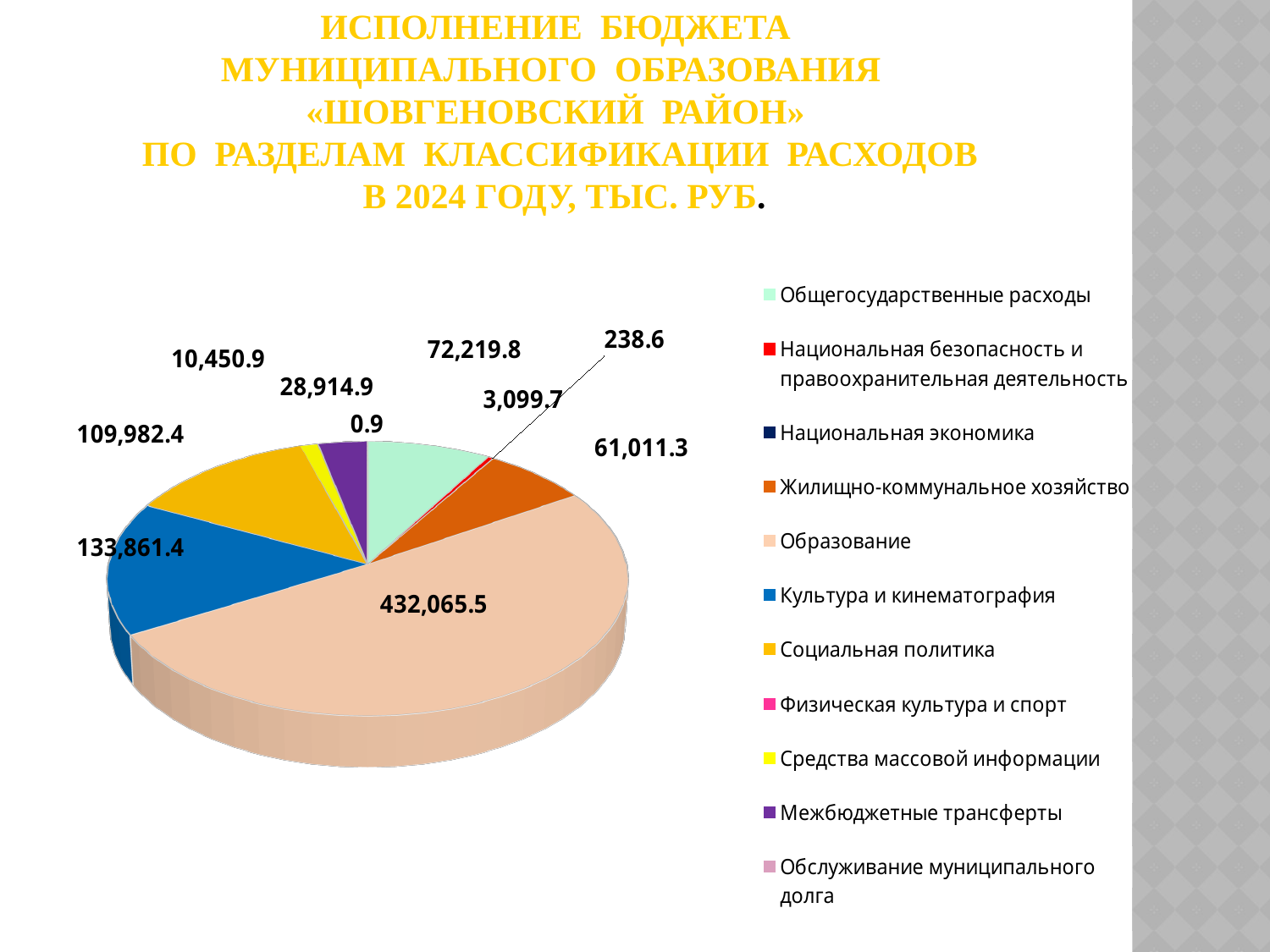
What is the difference between the values for Культура и кинематография and Социальная политика? 23,879.0 What is the value for Общегосударственные расходы? 72,219.8 Which is larger: Общегосударственные расходы or Жилищно-коммунальное хозяйство? Общегосударственные расходы What kind of chart is shown on the slide? pie chart In what unit are the values in the chart expressed, according to the title? тыс. руб. Which category has the largest slice of the pie? Образование What is the value for Образование? 432,065.5 How many categories does the legend list? 11 What is the value for Культура и кинематография? 133,861.4 What is the value for Социальная политика? 109,982.4 What is the value for Национальная безопасность и правоохранительная деятельность? 3,099.7 What is the value for Жилищно-коммунальное хозяйство? 61,011.3